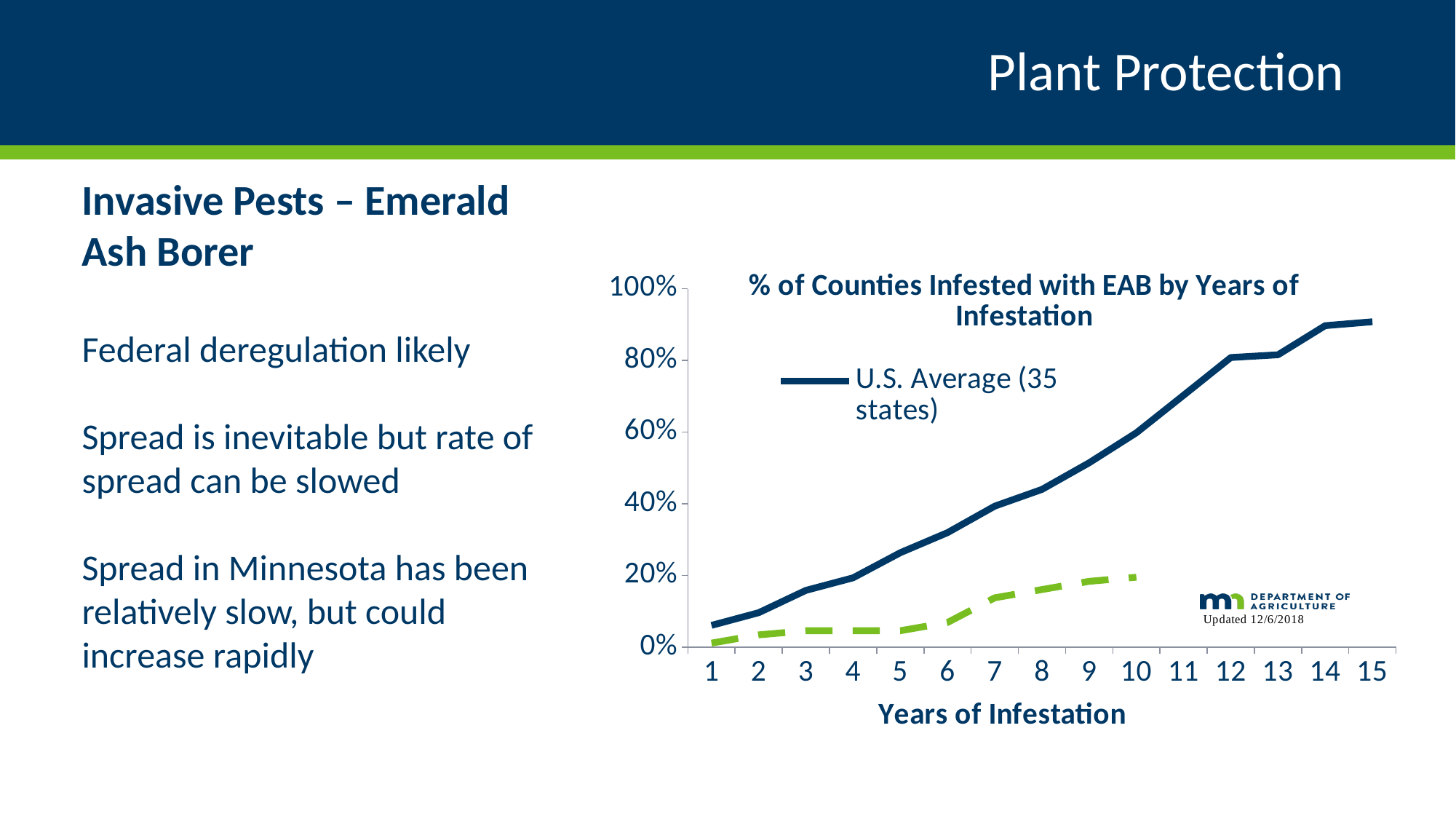
Is the U.S. Average (35 states) value at year 7 greater or less than 60%? less What is the label of the x axis? Years of Infestation At year 10, which line is higher: the U.S. Average (35 states) line or the green dashed line? U.S. Average (35 states) Is the green dashed line's value at year 5 greater or less than 20%? less What kind of chart is shown on the slide? line chart Does the U.S. Average (35 states) line rise or fall as years of infestation increase? rise Is the U.S. Average (35 states) value at year 15 greater or less than 80%? greater How many years of infestation are marked along the x axis? 15 What is the title of the chart? % of Counties Infested with EAB by Years of Infestation How many series does the chart legend list? 1